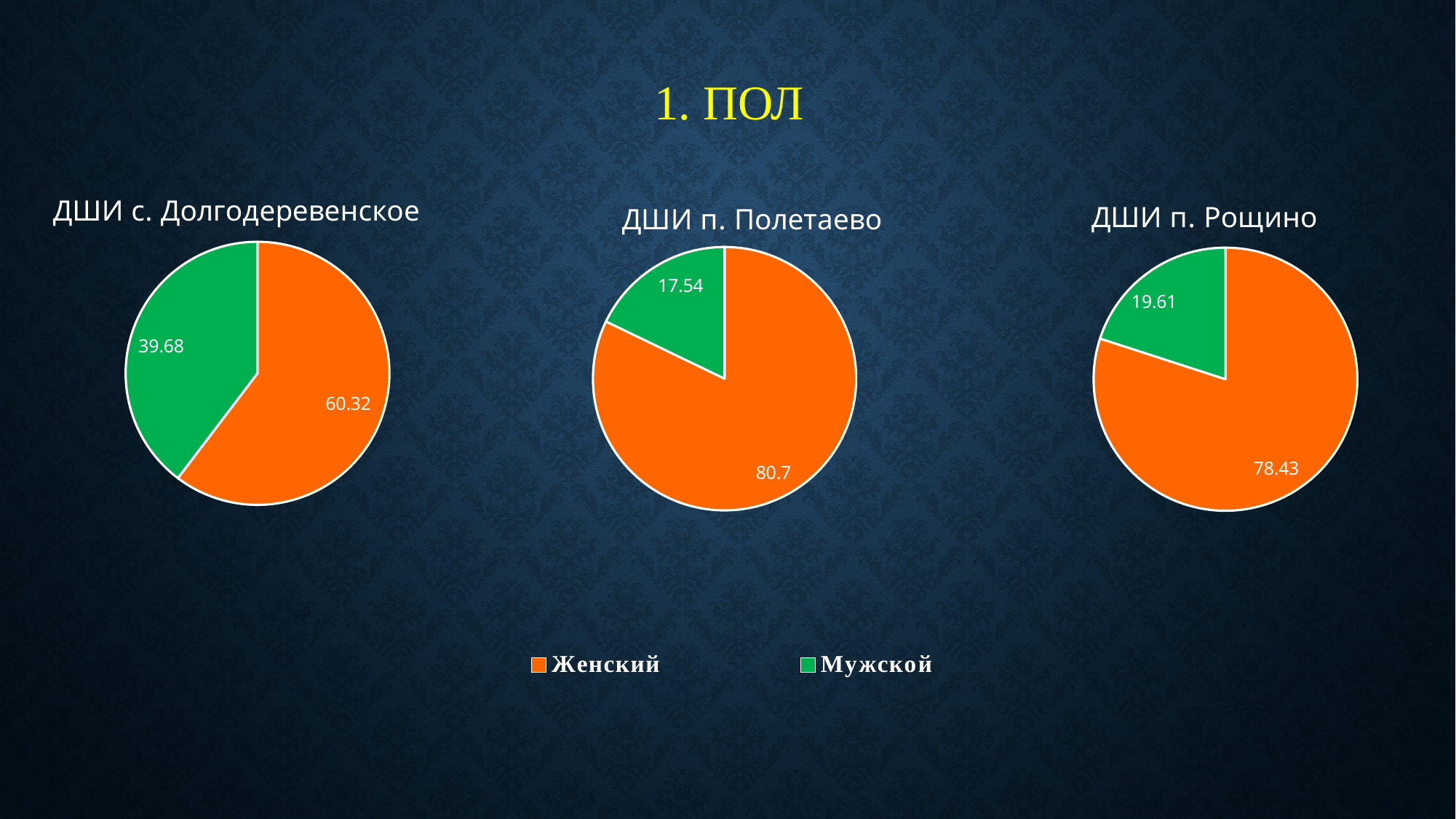
In the chart titled "ДШИ с. Долгодеревенское", what is the difference between the Женский and Мужской values? 20.64 In the chart titled "ДШИ п. Полетаево", what is the value for Мужской? 17.54 In the chart titled "ДШИ с. Долгодеревенское", which category has the largest slice? Женский In the chart titled "ДШИ п. Полетаево", which category has the smallest slice? Мужской What kind of chart is the chart titled "ДШИ п. Полетаево"? Pie chart In the chart titled "ДШИ п. Рощино", what is the value for Женский? 78.43 In the chart titled "ДШИ п. Полетаево", what is the value for Женский? 80.7 How many entries does the shared legend list? 2 In the chart titled "ДШИ с. Долгодеревенское", what is the value for Мужской? 39.68 In the chart titled "ДШИ п. Рощино", which is larger, the Женский value or the Мужской value? Женский In the chart titled "ДШИ п. Рощино", what is the value for Мужской? 19.61 In the chart titled "ДШИ с. Долгодеревенское", what is the value for Женский? 60.32